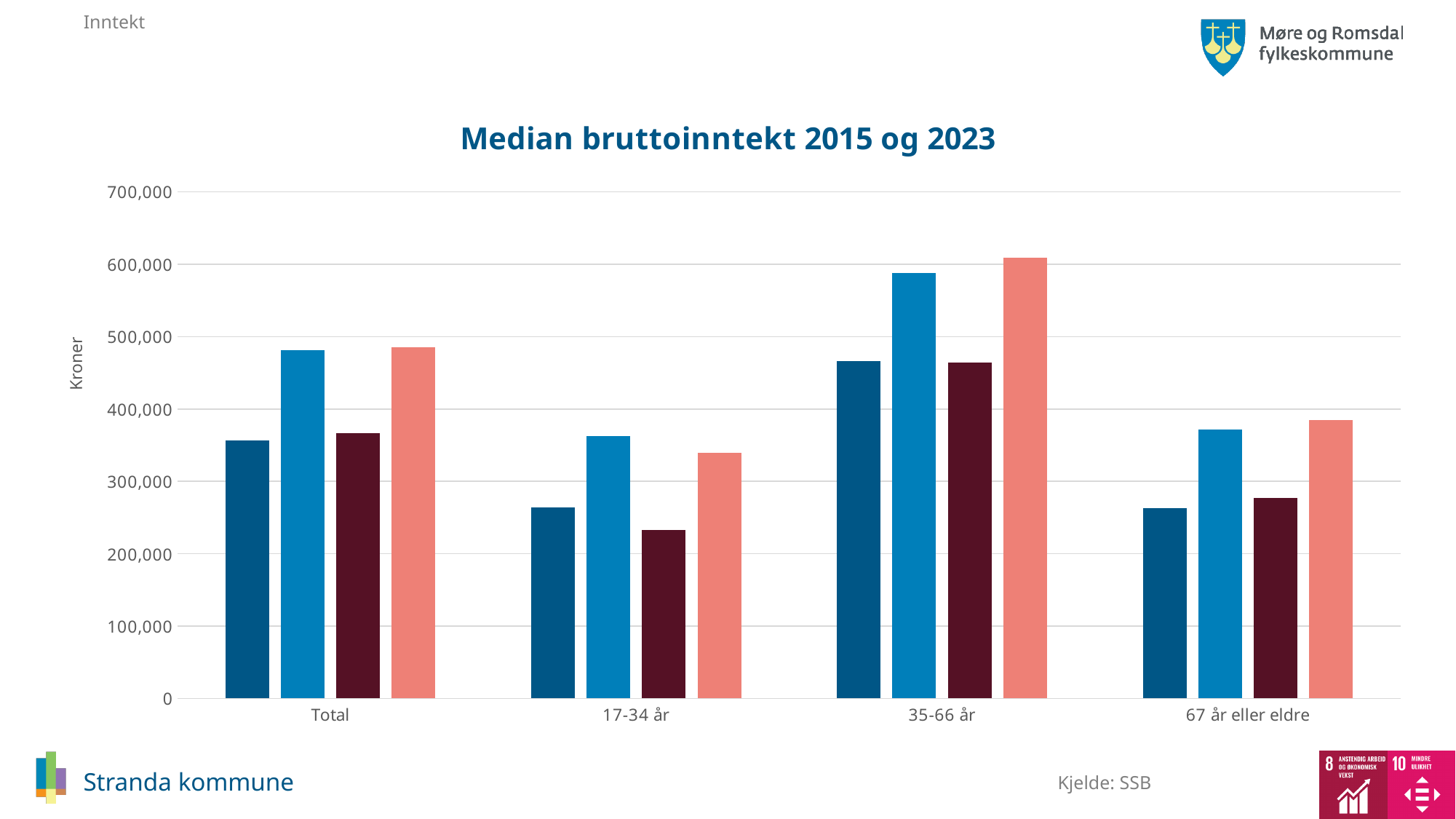
What kind of chart is shown on the slide? bar chart How many bars are plotted for each category on the x axis? 4 Which category on the x axis contains the shortest bar in the chart? 17-34 år Is the value of the tallest bar in the 35-66 år group greater or less than 500,000? greater How many categories are shown on the x axis of the chart? 4 Is the value of the dark blue (first) bar in the Total group greater or less than 400,000? less Which is taller: the dark blue (first) bar in the 35-66 år group or the dark blue (first) bar in the Total group? 35-66 år What is the label on the vertical axis of the chart? Kroner Is the value of the dark blue (first) bar in the 17-34 år group greater or less than 300,000? less Which category on the x axis contains the tallest bar in the chart? 35-66 år What is the title of the chart? Median bruttoinntekt 2015 og 2023